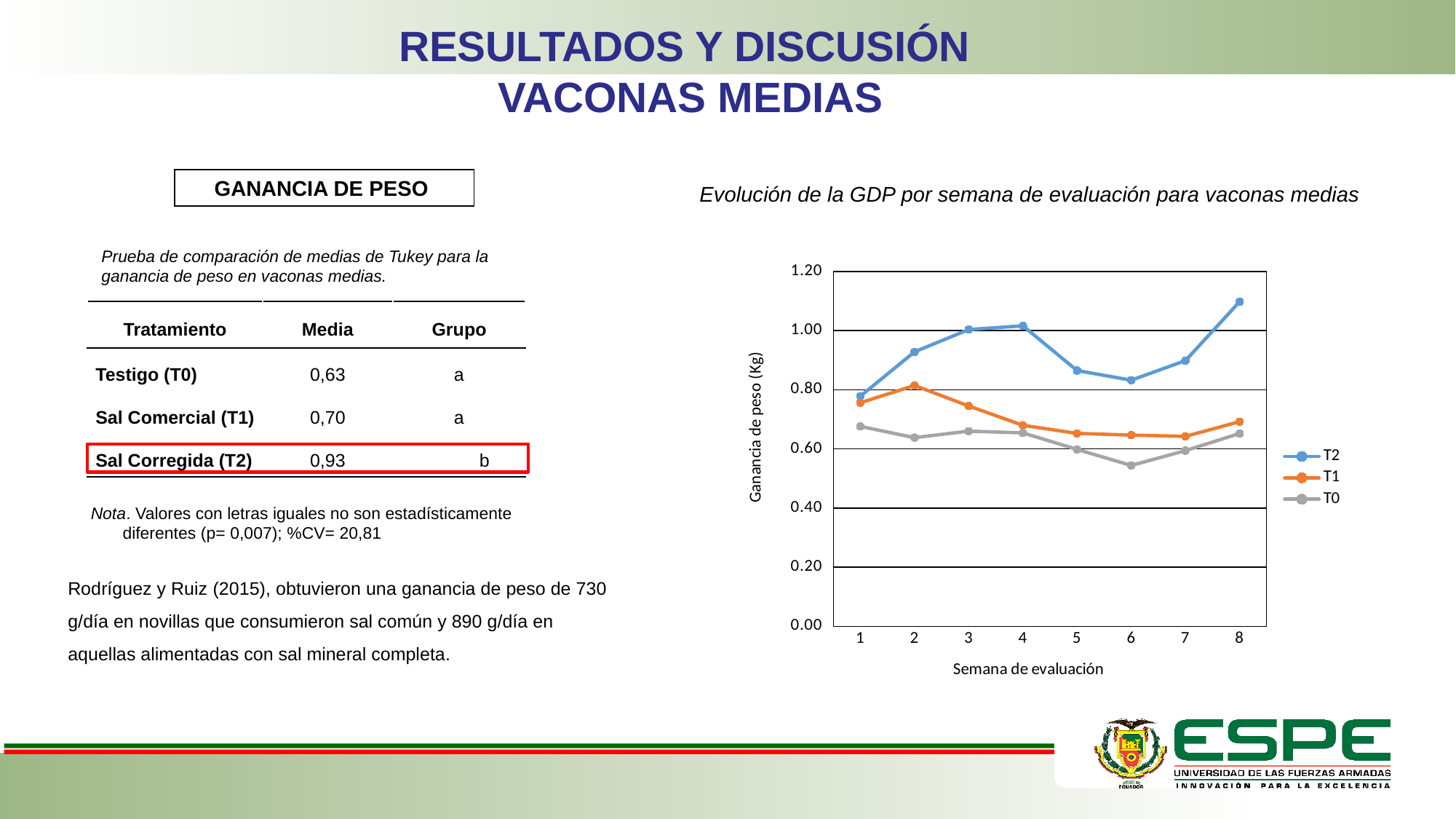
In week 4, which series has the larger value, T2 or T1? T2 In which week does the T2 series reach its highest value? 8 Is the value for T1 in week 1 greater or less than 0.80? less What is the label of the y axis of the chart? Ganancia de peso (Kg) How many series does the legend of the chart list? 3 In which week does the T1 series reach its highest value? 2 In which week does the T0 series reach its lowest value? 6 What kind of chart is shown on the slide? line chart Does the T2 series rise or fall from week 1 to week 4? rise How many evaluation weeks are plotted along the x axis of the chart? 8 Is the value for T0 in week 6 greater or less than 0.60? less Is the value for T2 in week 8 greater or less than 1.00? greater